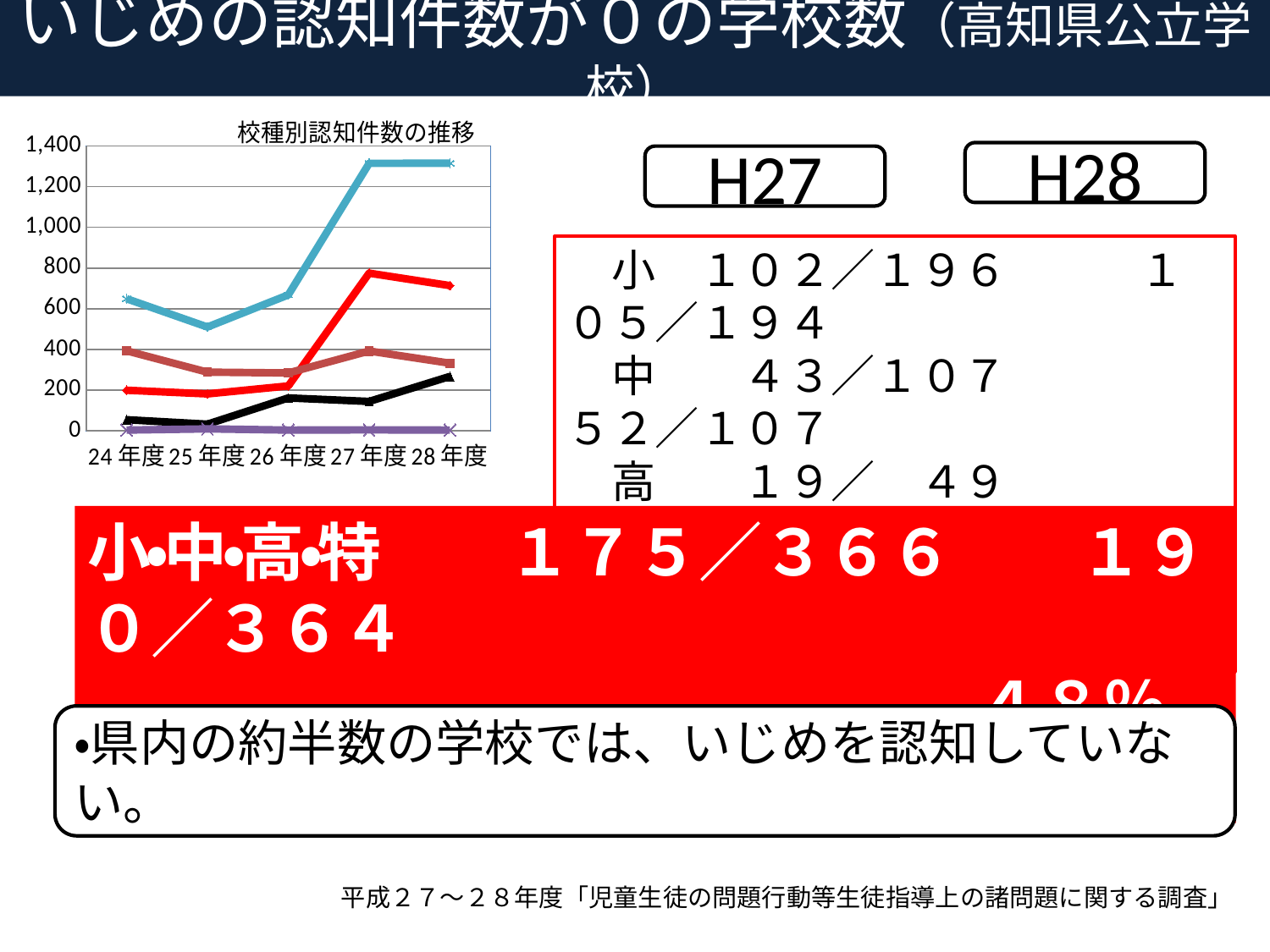
Is the value of the light blue line at 25年度 greater or less than 600? less In which fiscal year does the light blue line reach its lowest value? 25年度 What is the highest value shown on the y axis of the chart? 1,400 Which line has the larger value at 28年度, the light blue line or the red line? the light blue line What kind of chart is shown on the slide? line chart How many lines are plotted in the chart? 5 Does the light blue line rise or fall from 26年度 to 27年度? rise How many fiscal years are shown on the x axis of the chart? 5 What is the title of the chart on the slide? 校種別認知件数の推移 Is the value of the light blue line at 28年度 greater or less than 1,200? greater Is the value of the brown line at 24年度 greater or less than 600? less